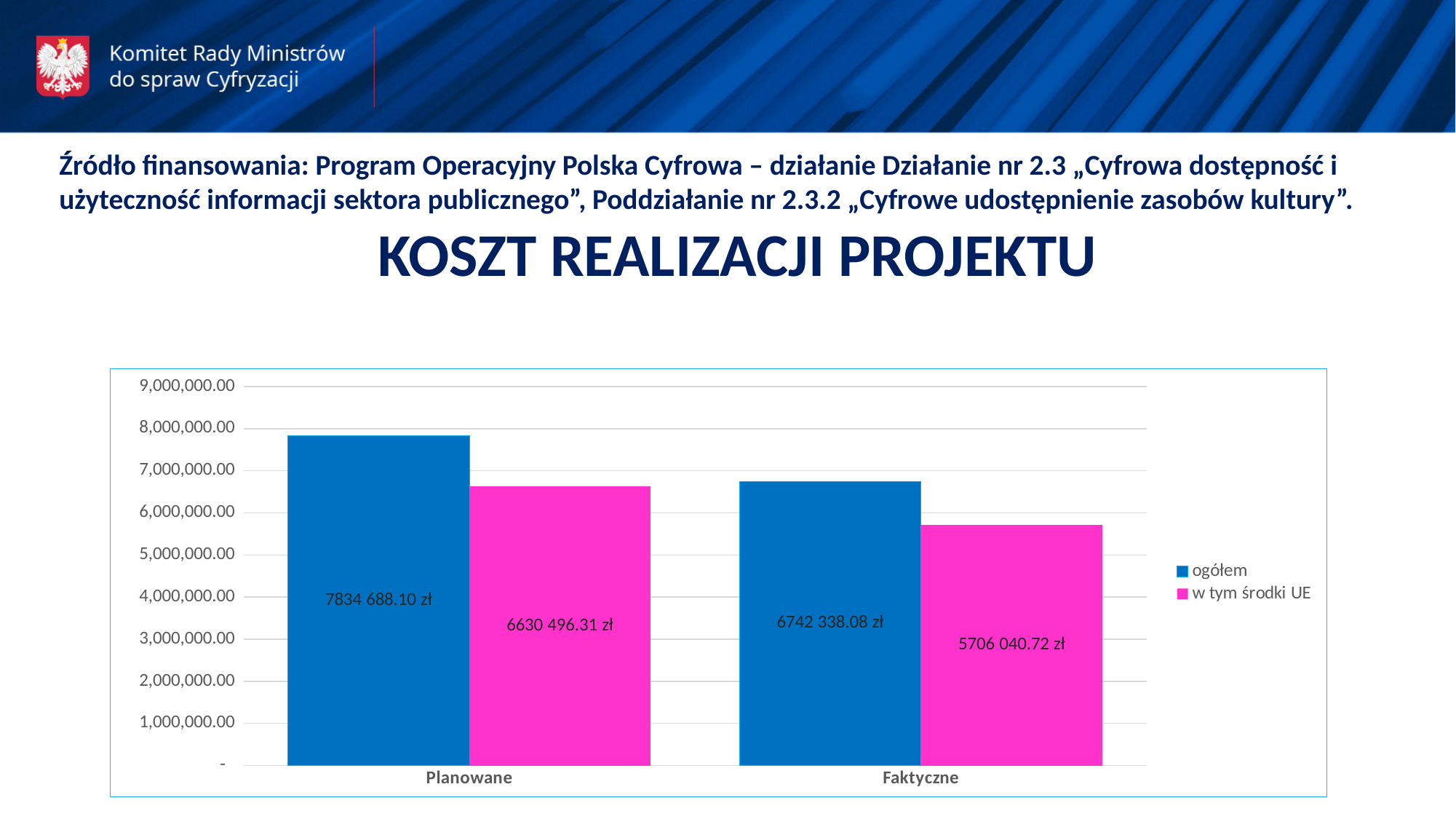
What is the value of the 'w tym środki UE' bar for Planowane? 6630 496.31 zł Which is larger: the 'w tym środki UE' value for Planowane or the 'ogółem' value for Faktyczne? ogółem for Faktyczne What is the difference between the 'ogółem' and 'w tym środki UE' values for Planowane? 1204 191.79 zł What type of chart is shown on the slide? Bar chart How many categories are shown on the x axis of the chart? 2 What is the value of the 'ogółem' bar for Faktyczne? 6742 338.08 zł Which bar in the chart has the lowest value? w tym środki UE for Faktyczne What is the value of the 'w tym środki UE' bar for Faktyczne? 5706 040.72 zł Which bar in the chart has the highest value? ogółem for Planowane What is the value of the 'ogółem' bar for Planowane? 7834 688.10 zł How many series does the chart legend list? 2 What is the difference between the 'ogółem' values for Planowane and Faktyczne? 1092 350.02 zł